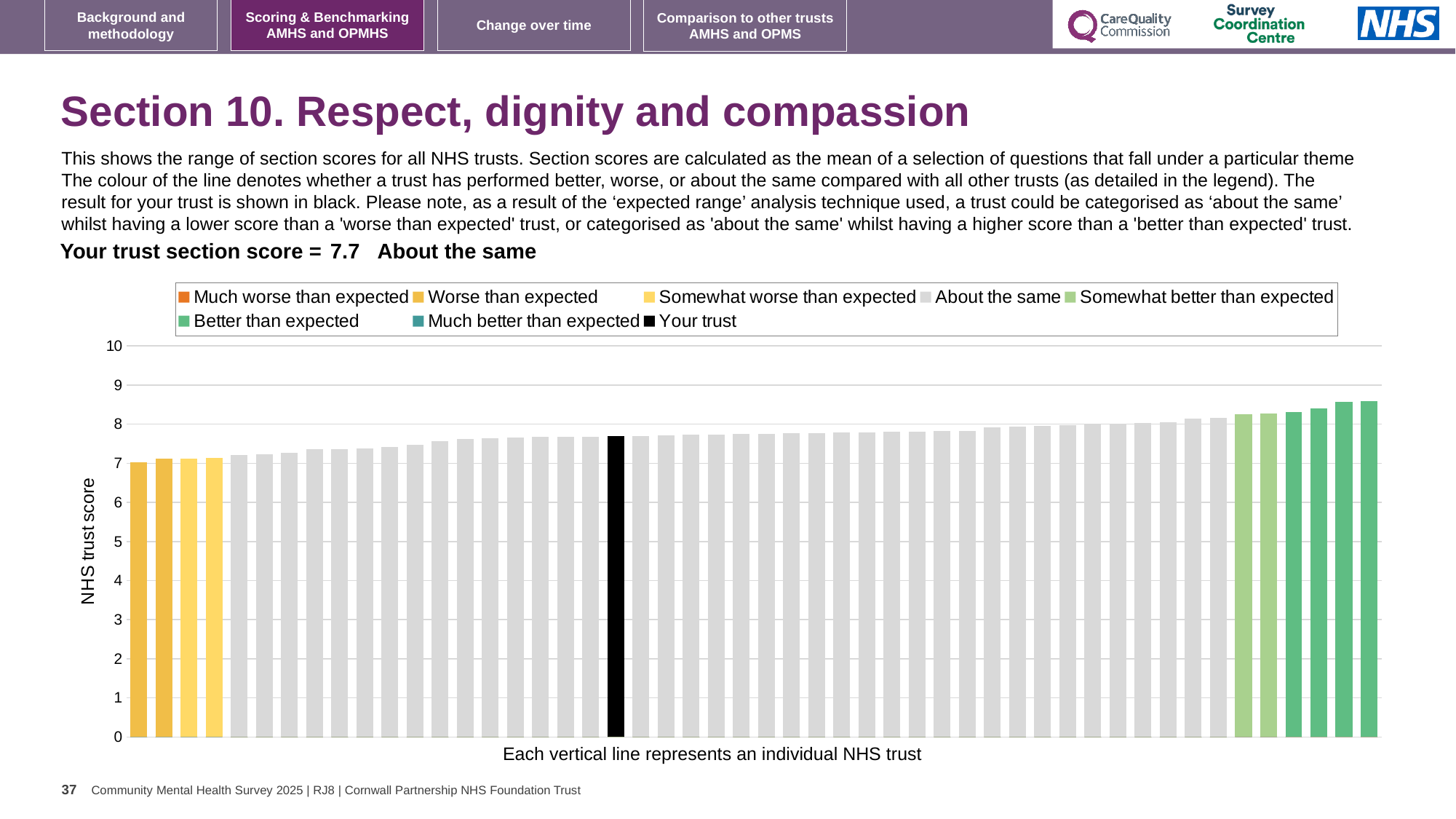
Is the value of the leftmost (lowest) bar greater or less than 8? less Is the value for your trust (the black bar) greater or less than 7? greater Do the bar values rise or fall from left to right along the x axis? rise Is the value of the highest bar greater or less than 9? less How many entries does the chart legend list? 8 What is the section score for your trust? 7.7 What kind of chart is shown on the slide? bar chart What colour is the bar representing your trust? black Which category is your trust placed in for this section? About the same Which is larger, the value of the black bar or the value of the leftmost bar? the black bar What is the label on the vertical axis of the chart? NHS trust score